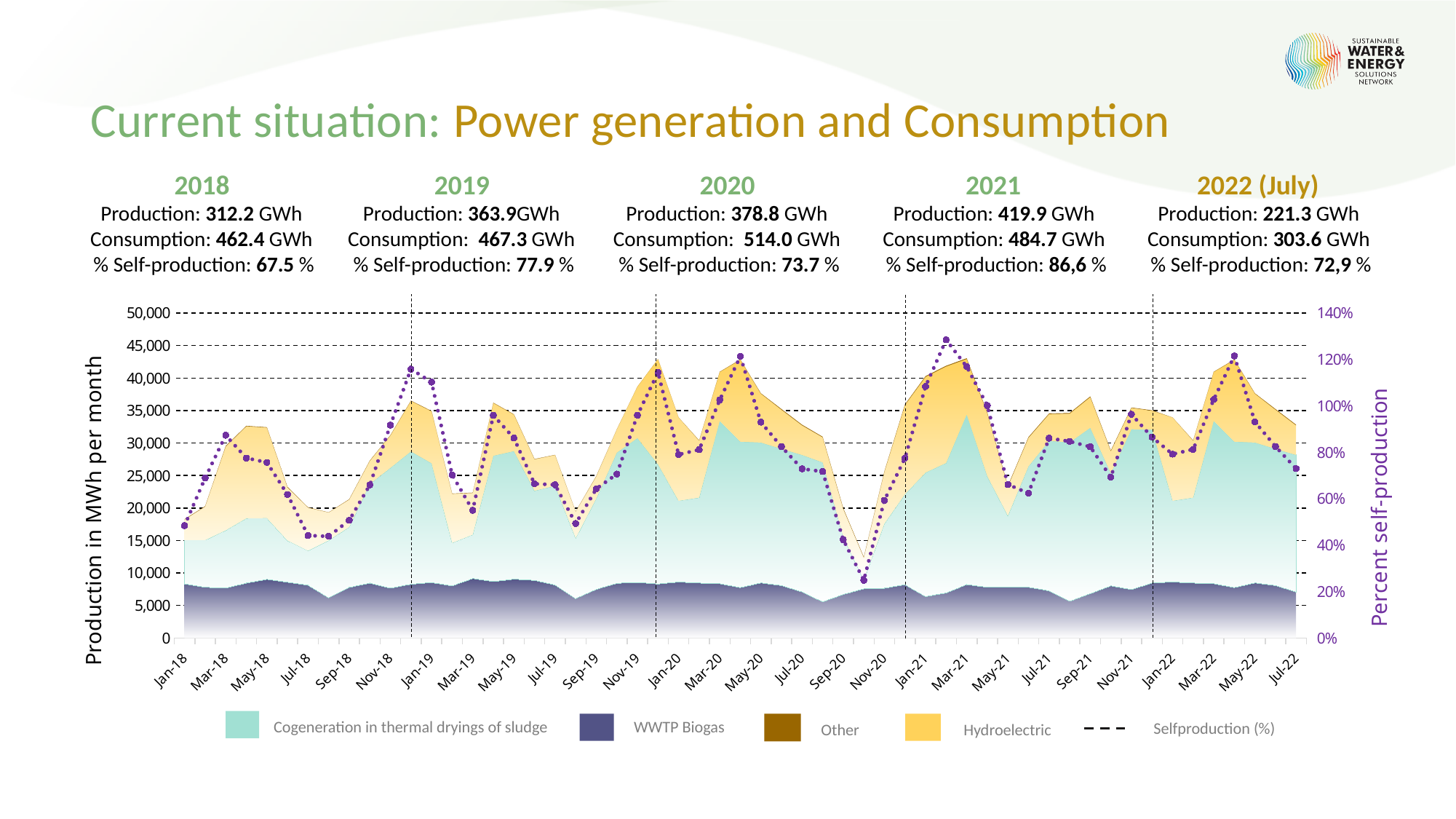
Is the Selfproduction (%) value for Jul-18 greater or less than 60%? less What kind of chart is shown on the slide? combination area and line chart What is the label of the right vertical axis of the chart? Percent self-production Is the total monthly production for Dec-18 greater or less than 30,000 MWh? greater How many series does the chart legend list? 5 What is the label of the left vertical axis of the chart? Production in MWh per month In which month does the Selfproduction (%) line reach its highest value? Feb-21 In which month does the Selfproduction (%) line reach its lowest value? Oct-20 Is the Selfproduction (%) value for Feb-21 greater or less than 120%? greater Is the Selfproduction (%) value for Feb-21 larger or smaller than the value for Dec-18? larger